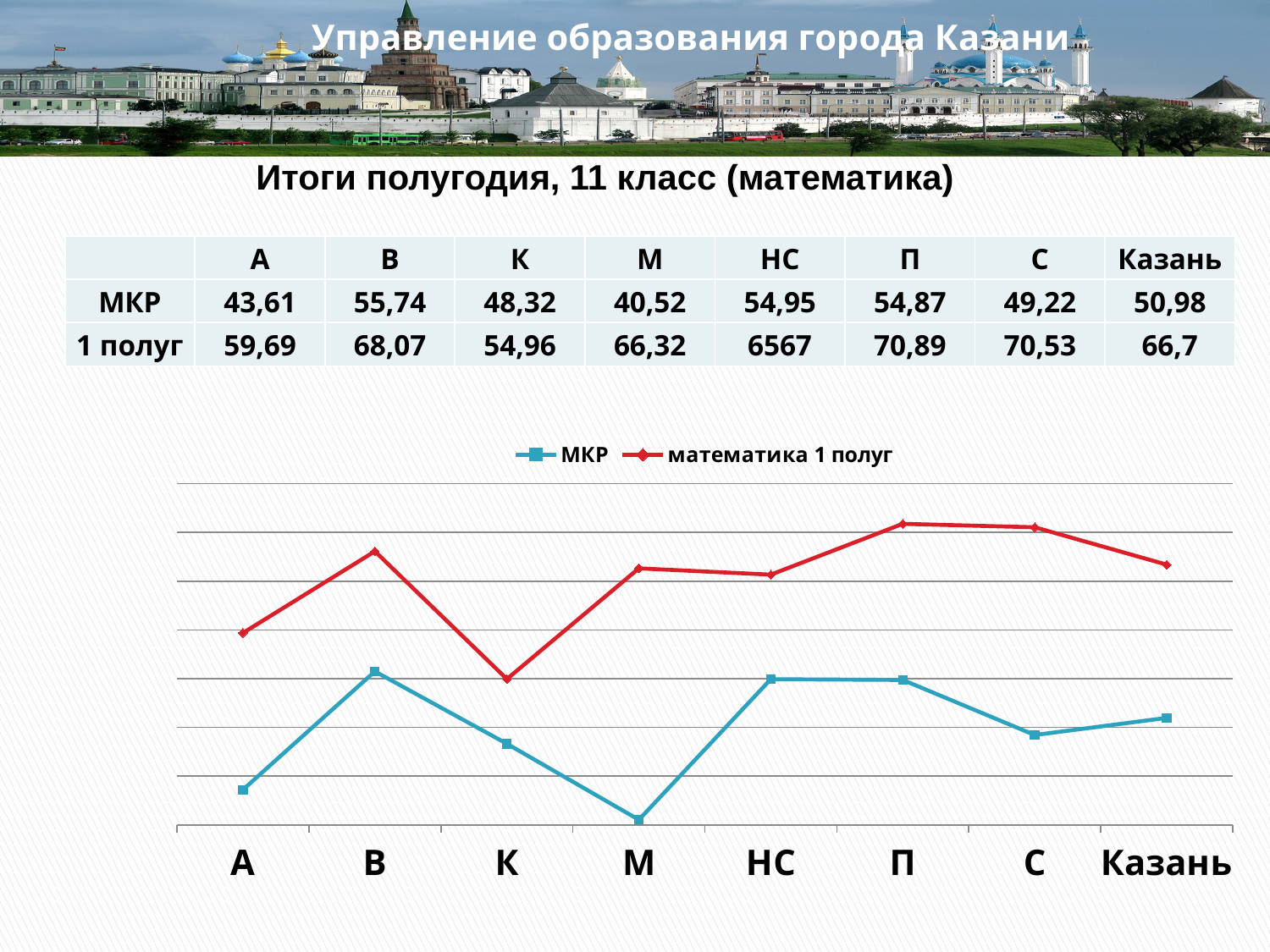
Which category has the lowest value for the математика 1 полуг series? К For the МКР series, which is larger: the value for В or the value for М? В Using the table values, what is the difference between the 1 полуг and МКР values for Казань? 15,72 Does the МКР line rise or fall from В to М? fall According to the table, what is the МКР value for Казань? 50,98 At category Казань, which series has the larger value, МКР or математика 1 полуг? математика 1 полуг How many series does the chart legend list? 2 How many categories are shown along the x axis of the chart? 8 What kind of chart is shown on the slide? line chart According to the table, what is the 1 полуг value for П? 70,89 Which category has the lowest value for the МКР series? М Does the математика 1 полуг line rise or fall from К to М? rise